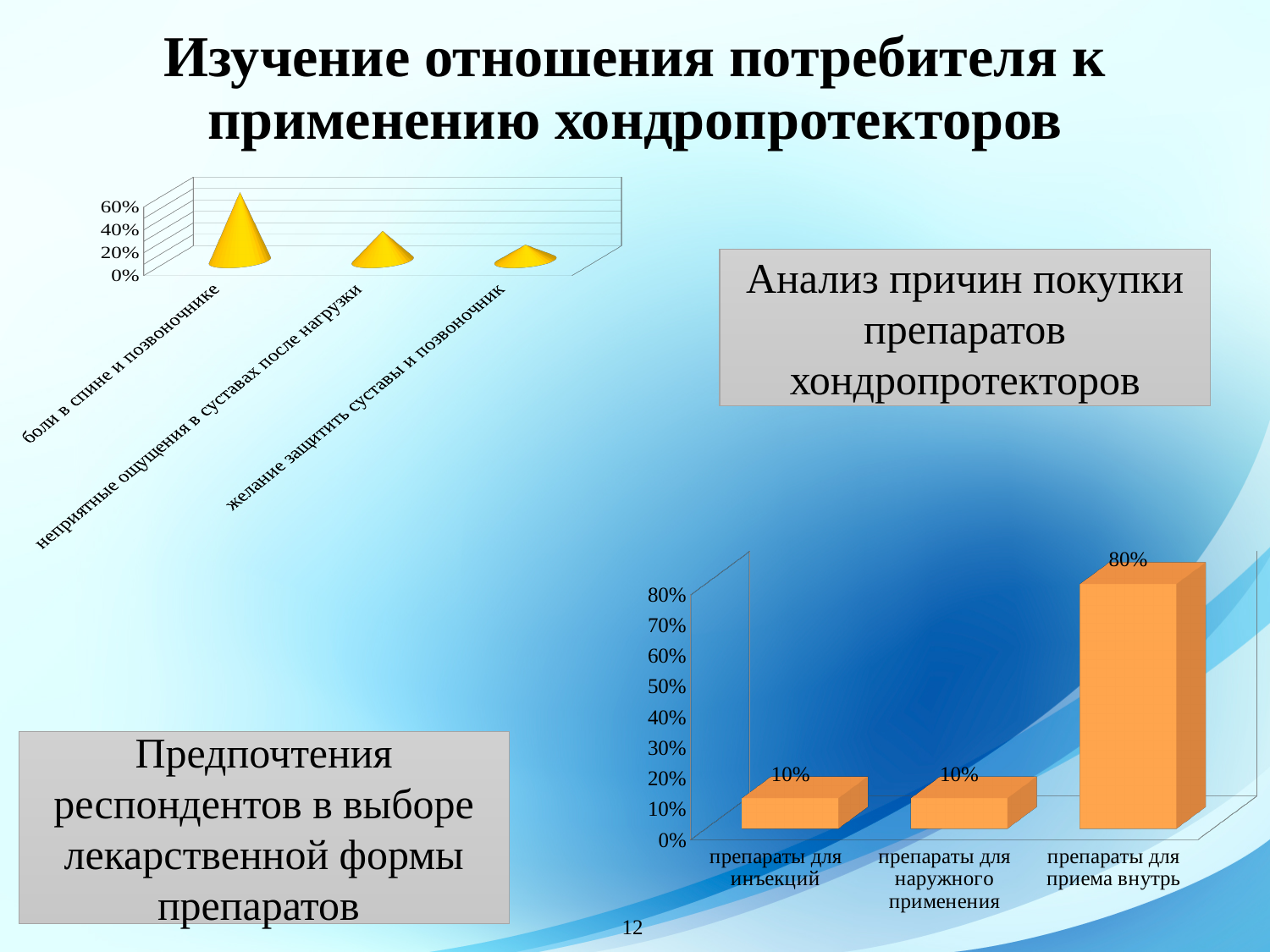
In the top-left chart on reasons for purchase, which category has the highest value? боли в спине и позвоночнике What kind of chart is the bottom-right chart on drug form preferences? bar chart In the bottom-right chart on drug form preferences, what is the value for препараты для приема внутрь? 80% In the bottom-right chart on drug form preferences, which category has the highest value? препараты для приема внутрь In the bottom-right chart on drug form preferences, what is the value for препараты для инъекций? 10% In the bottom-right chart on drug form preferences, what is the difference between препараты для приема внутрь and препараты для инъекций? 70% In the bottom-right chart on drug form preferences, what is the value for препараты для наружного применения? 10% In the top-left chart on reasons for purchase, is the value for боли в спине и позвоночнике greater or less than 40%? greater In the bottom-right chart on drug form preferences, how many categories are shown? 3 In the top-left chart on reasons for purchase, is the value for неприятные ощущения в суставах после нагрузки greater or less than 40%? less In the top-left chart on reasons for purchase, how many categories are shown? 3 In the top-left chart on reasons for purchase, which category has the lowest value? желание защитить суставы и позвоночник